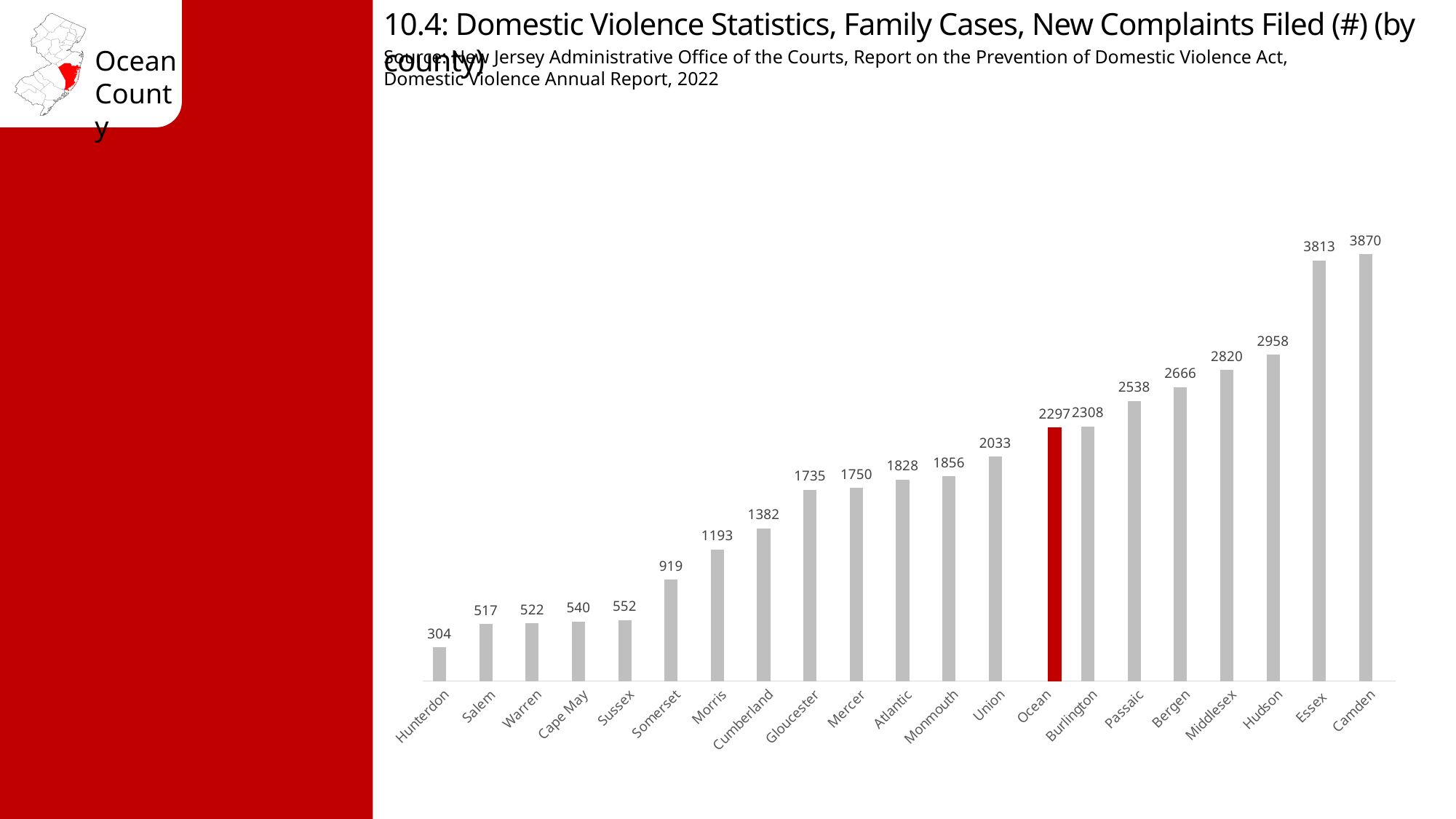
Which county has the lowest number of new complaints filed? Hunterdon What is the value shown for Hunterdon? 304 What is the difference between the values for Camden and Ocean? 1573 What is the value shown for Essex? 3813 Which county's bar is highlighted in red? Ocean What is the difference between the values for Burlington and Ocean? 11 How many counties are shown in the chart? 21 What type of chart is shown on the slide? Bar chart Which has a higher value, Somerset or Morris? Morris Which county has the highest number of new complaints filed? Camden Which has a higher value, Hudson or Middlesex? Hudson What is the number of new domestic violence complaints filed for Ocean County? 2297